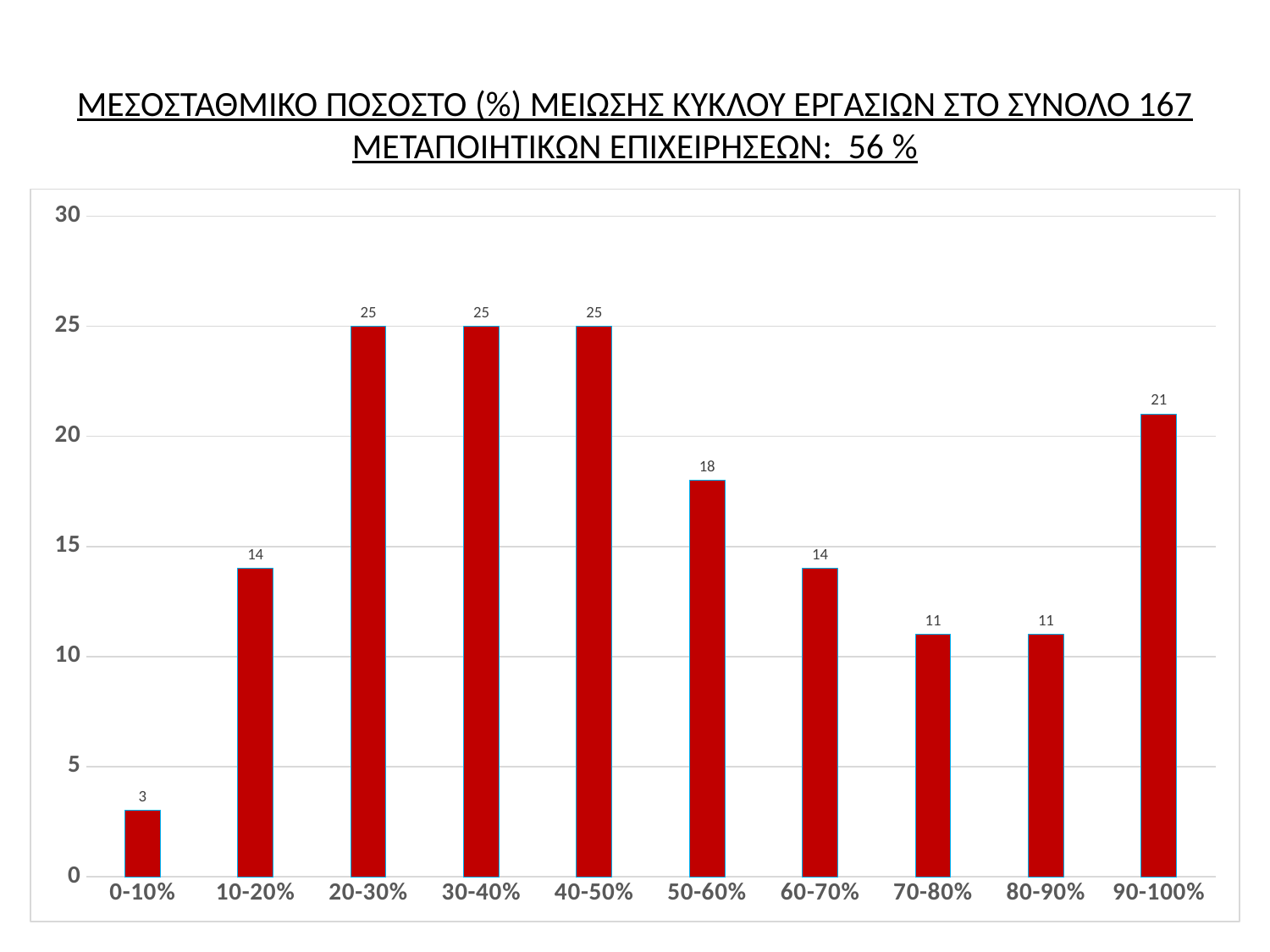
What kind of chart is shown on the slide? bar chart What is the value for the 90-100% category? 21 What colour are the bars in the chart? red What is the difference between the values for 20-30% and 10-20%? 11 Do the values rise or fall from 40-50% to 80-90%? fall What is the value for the 50-60% category? 18 How many categories are shown on the x axis? 10 Which is larger, the value for 50-60% or the value for 70-80%? 50-60% Which category has the lowest value? 0-10% What is the value for the 0-10% category? 3 Is the value for 90-100% greater or less than 20? greater What is the difference between the values for 90-100% and 60-70%? 7